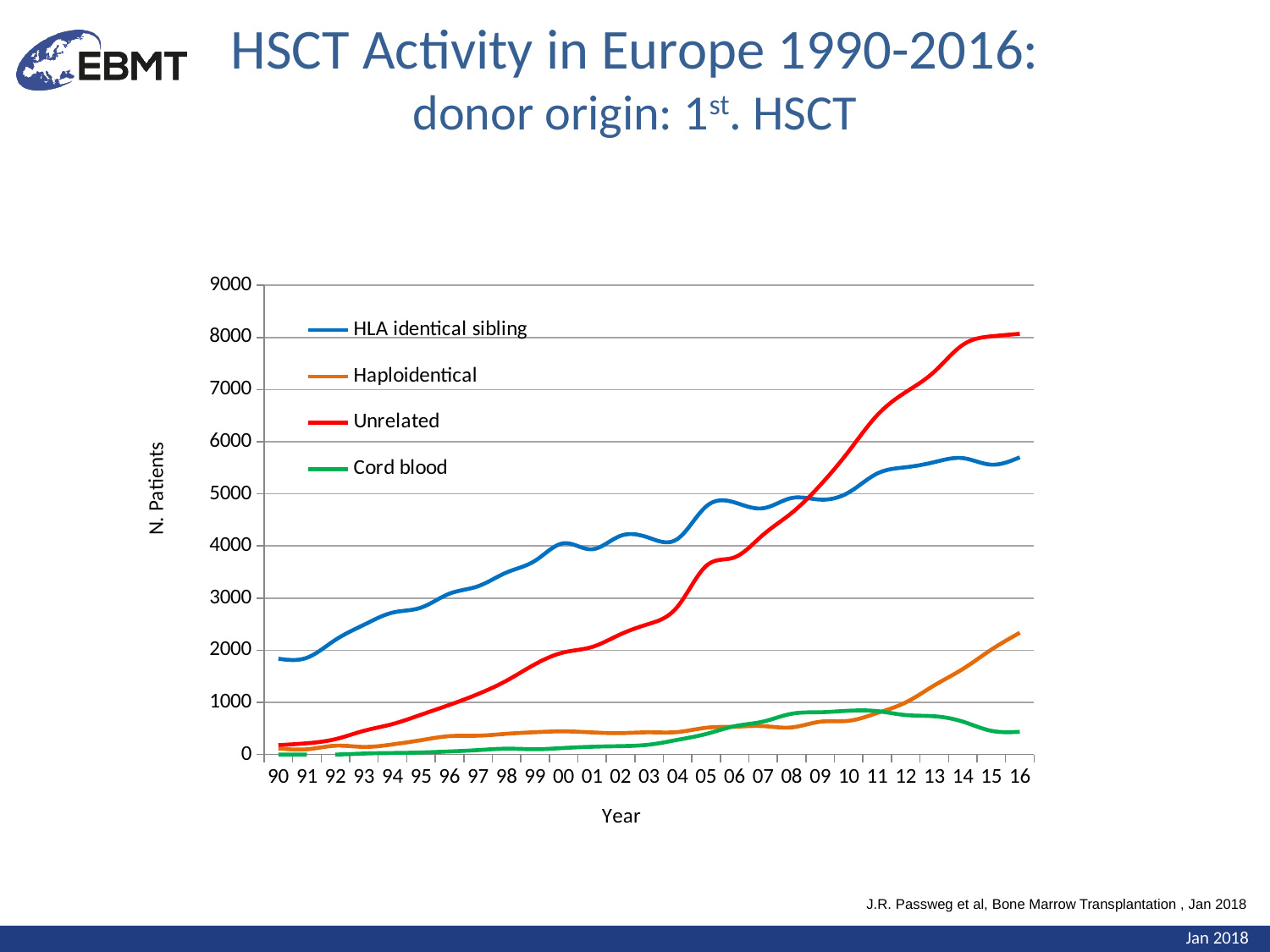
In year 05, which is larger: HLA identical sibling or Unrelated? HLA identical sibling Which series has the highest value in year 16? Unrelated Does the Unrelated series generally rise or fall from year 90 to year 16? rise Is the value for Haploidentical in year 16 greater or less than 2000? greater Which series has the lowest value in year 16? Cord blood How many series does the legend list? 4 Is the value for HLA identical sibling in year 90 greater or less than 2000? less How many years are shown along the x axis? 27 Is the value for Unrelated in year 16 greater or less than 7000? greater What is the label of the y axis? N. Patients Which series has the highest value in year 90? HLA identical sibling What kind of chart is shown on the slide? line chart